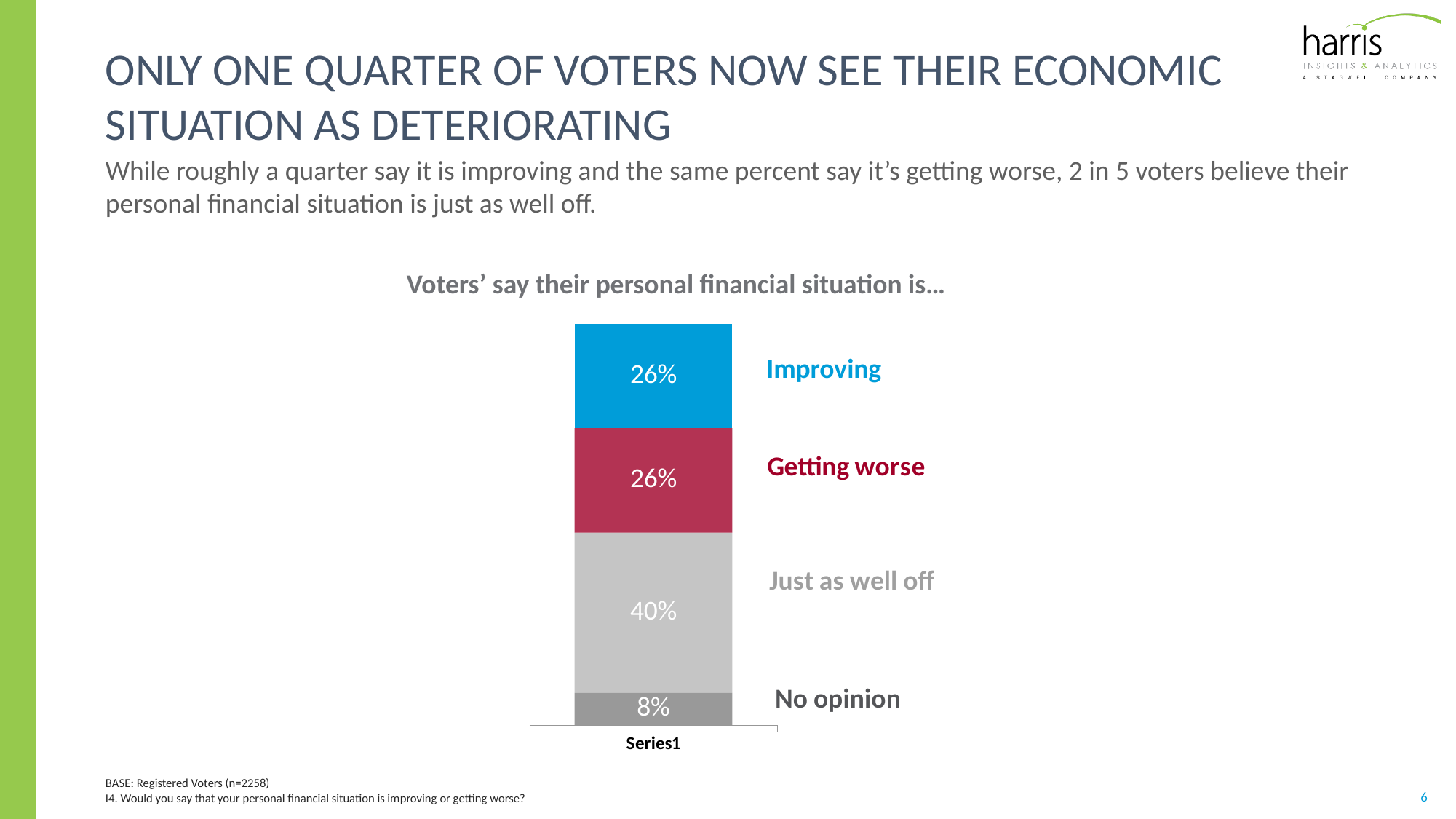
How many segments make up the stacked bar? 4 Which is larger: the share saying 'Just as well off' or the share saying 'Getting worse'? Just as well off Which response has the smallest share of voters? No opinion What is the title of the chart? Voters' say their personal financial situation is... What percentage of voters say their personal financial situation is getting worse? 26% What percentage of voters have no opinion on their personal financial situation? 8% What is the difference between the share saying 'Getting worse' and the share with 'No opinion'? 18 percentage points Which response has the largest share of voters? Just as well off What is the difference between the share saying 'Just as well off' and the share saying 'Improving'? 14 percentage points What type of chart is shown on the slide? Stacked bar chart What percentage of voters say their personal financial situation is improving? 26% What percentage of voters say their personal financial situation is just as well off? 40%